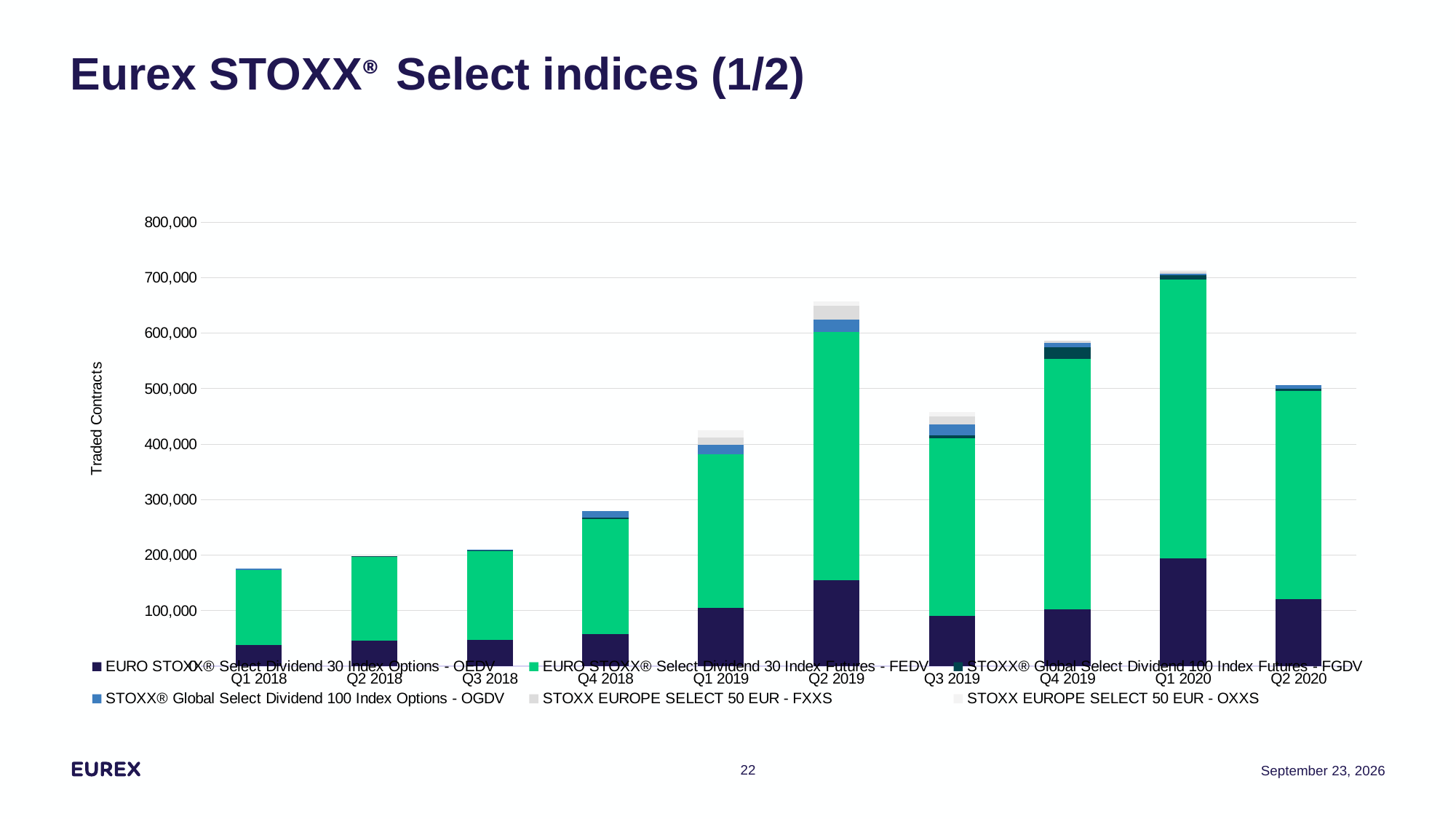
How many quarters are shown along the x axis of the chart? 10 Which quarter has a larger total, Q2 2019 or Q4 2019? Q2 2019 How many series does the chart's legend list? 6 Which quarter has the highest total traded contracts? Q1 2020 What is the title of the vertical axis? Traded Contracts Is the total for Q4 2018 greater or less than 300,000? less Is the total for Q1 2018 greater or less than 200,000? less Which quarter has the lowest total traded contracts? Q1 2018 Is the total for Q2 2019 greater or less than 600,000? greater Do the total traded contracts rise or fall from Q1 2018 to Q2 2019? rise What kind of chart is shown on the slide? Stacked bar chart